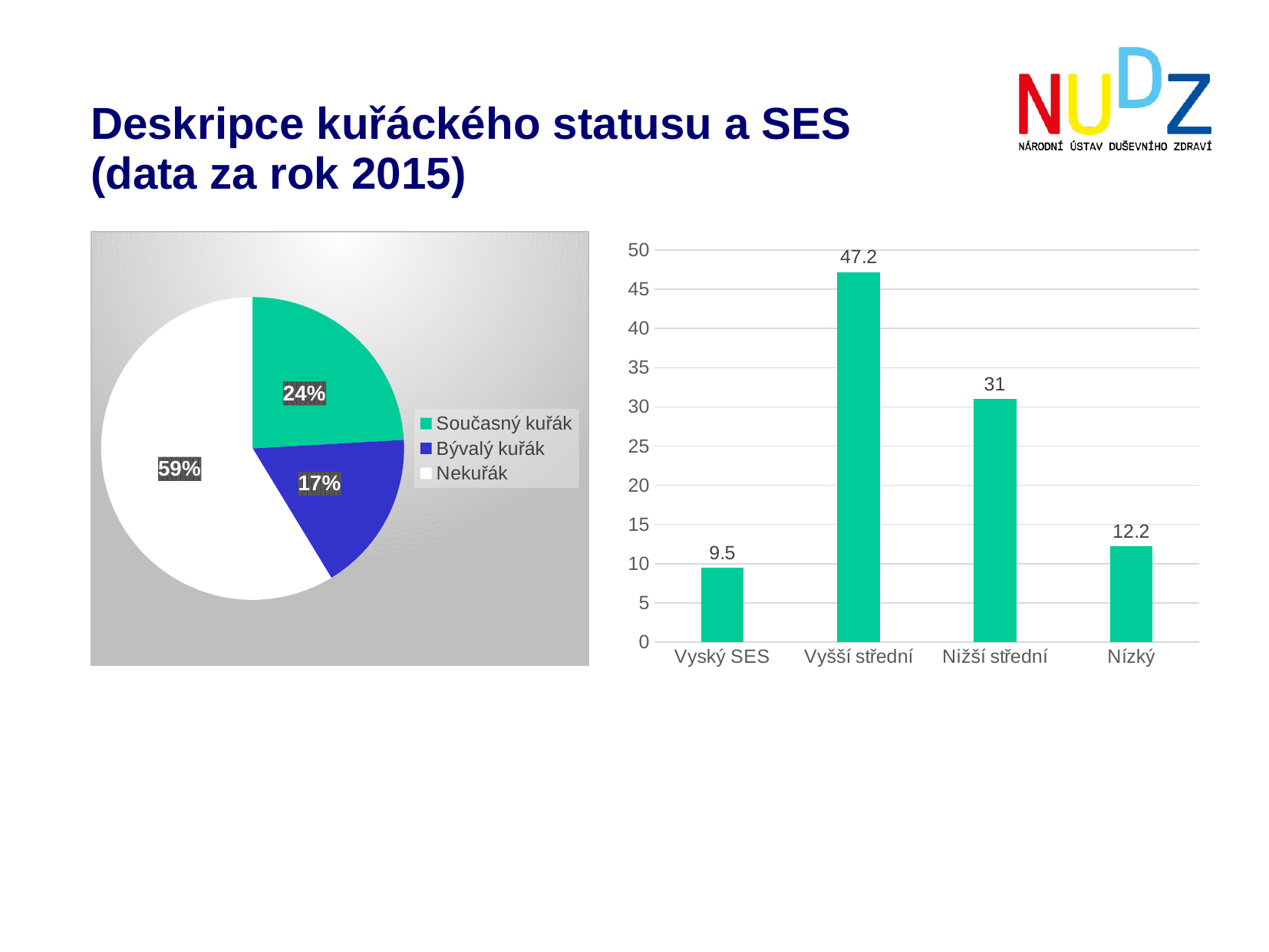
In the bar chart on the right, what is the value for Nízký? 12.2 In the bar chart on the right, what is the difference between the values for Vyšší střední and Nižší střední? 16.2 In the bar chart on the right, how many categories are shown on the x axis? 4 In the bar chart on the right, which is larger, the value for Nízký or the value for Vyský SES? Nízký In the pie chart on the left, which category has the largest slice? Nekuřák In the pie chart on the left, which category has the smallest slice? Bývalý kuřák In the pie chart on the left, what share does Bývalý kuřák have? 17% In the bar chart on the right, which category has the lowest value? Vyský SES In the pie chart on the left, how many entries does the legend list? 3 In the pie chart on the left, what share does Současný kuřák have? 24% In the bar chart on the right, what is the value for Vyšší střední? 47.2 In the pie chart on the left, what share does Nekuřák have? 59%